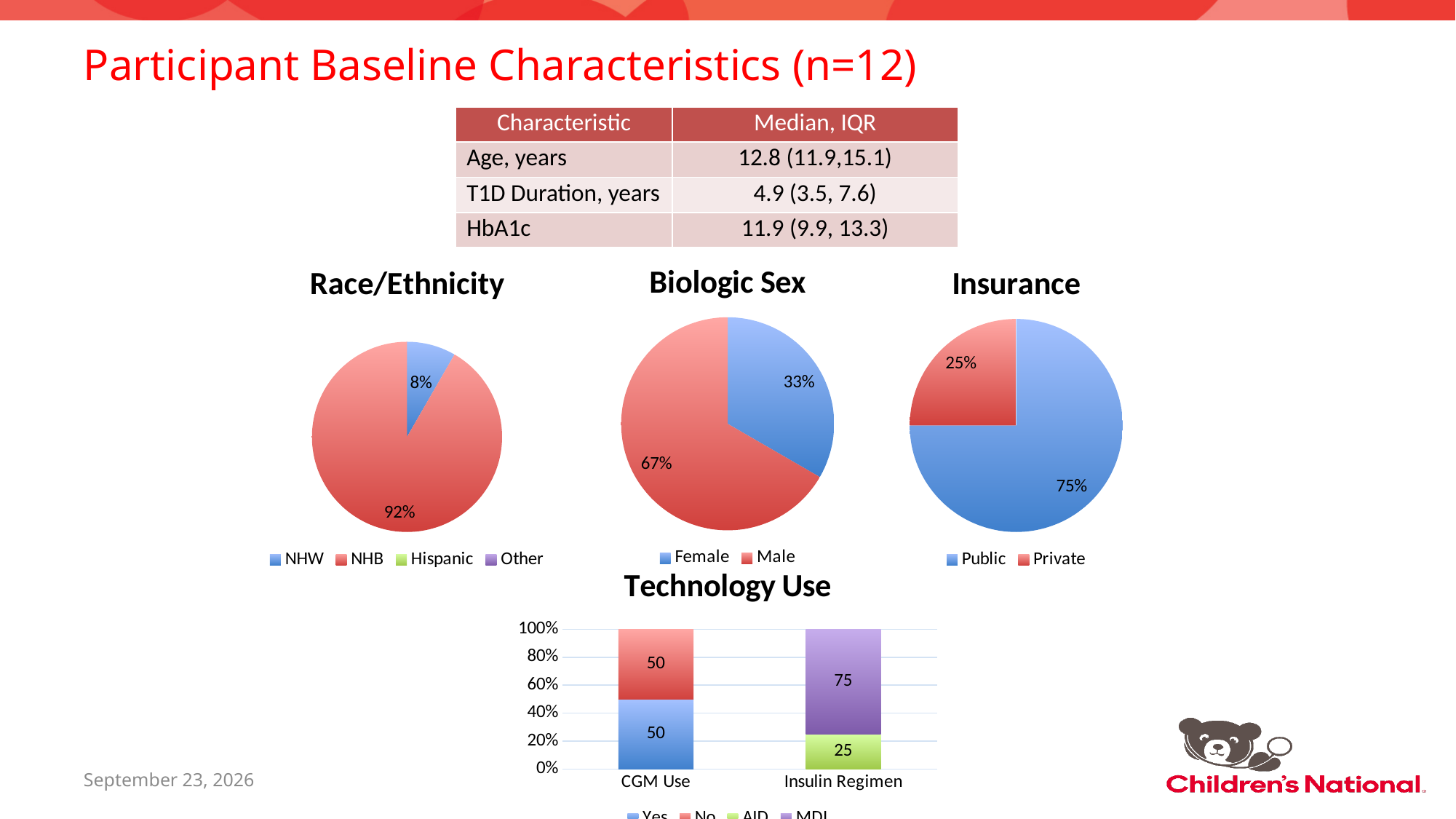
In the Technology Use chart, what value is shown for the purple segment of the Insulin Regimen bar? 75 In the Race/Ethnicity chart, what percentage is shown for NHB? 92% In the Biologic Sex chart, what percentage is shown for Female? 33% In the Race/Ethnicity chart, how many entries does the legend list? 4 In the Insurance chart, what percentage is shown for Public? 75% In the Biologic Sex chart, what percentage is shown for Male? 67% In the Insurance chart, what is the difference in percentage points between Public and Private? 50 In the Technology Use chart, how many categories are shown on the x axis? 2 What kind of chart is the Technology Use chart? Bar chart In the Race/Ethnicity chart, what percentage is shown for NHW? 8% In the Biologic Sex chart, which category has the larger share, Female or Male? Male What kind of chart is the Insurance chart? Pie chart